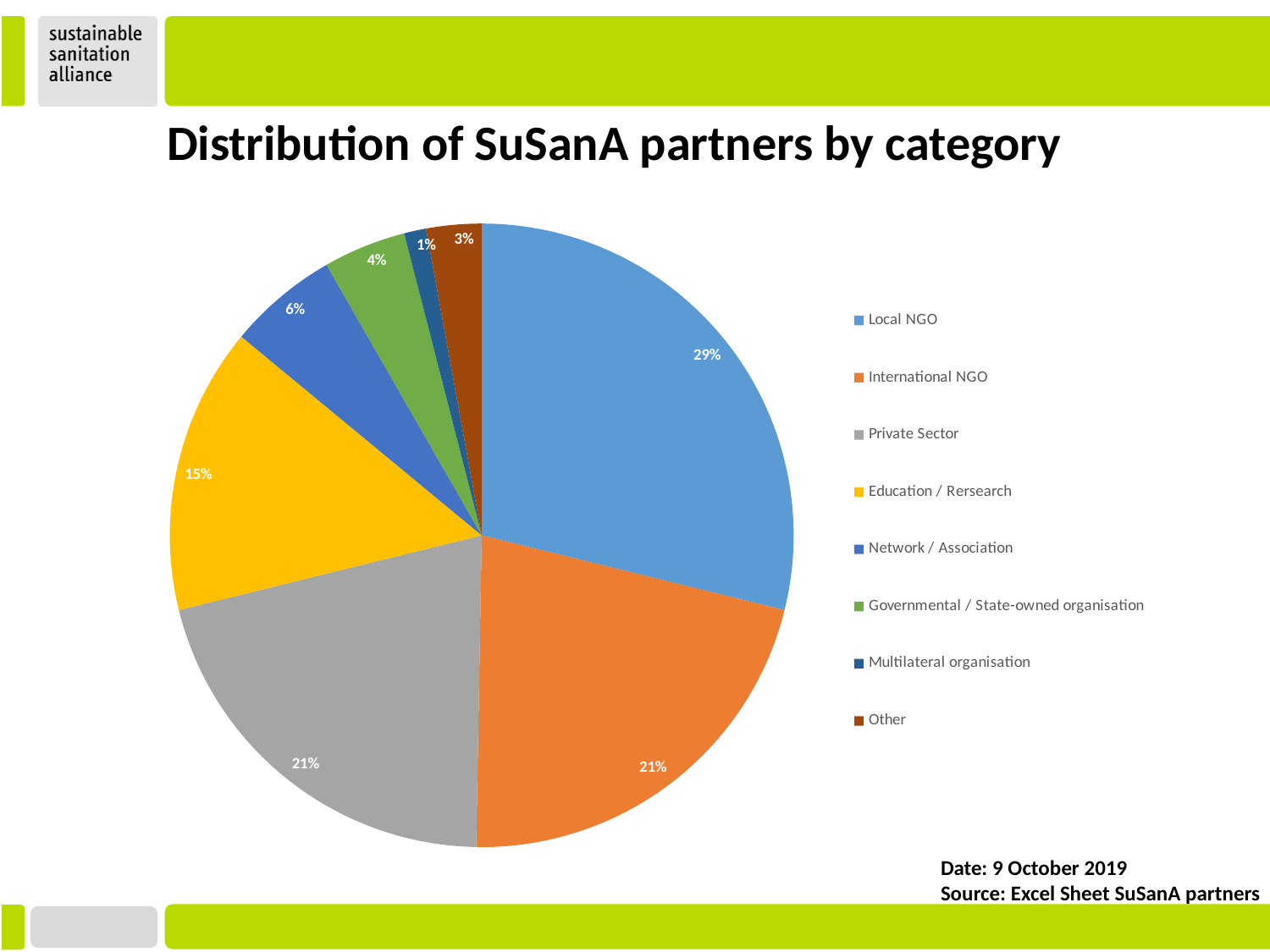
What share of SuSanA partners fall under Other? 3% What share of SuSanA partners are Local NGOs? 29% Which is larger, the share for Network / Association or the share for Other? Network / Association Which category has the largest share of SuSanA partners? Local NGO What share of SuSanA partners are Governmental / State-owned organisations? 4% Which category has the smallest share of SuSanA partners? Multilateral organisation What kind of chart is shown on the slide? pie chart What is the difference in percentage points between the Local NGO share and the Education / Rersearch share? 14 How many categories does the legend list? 8